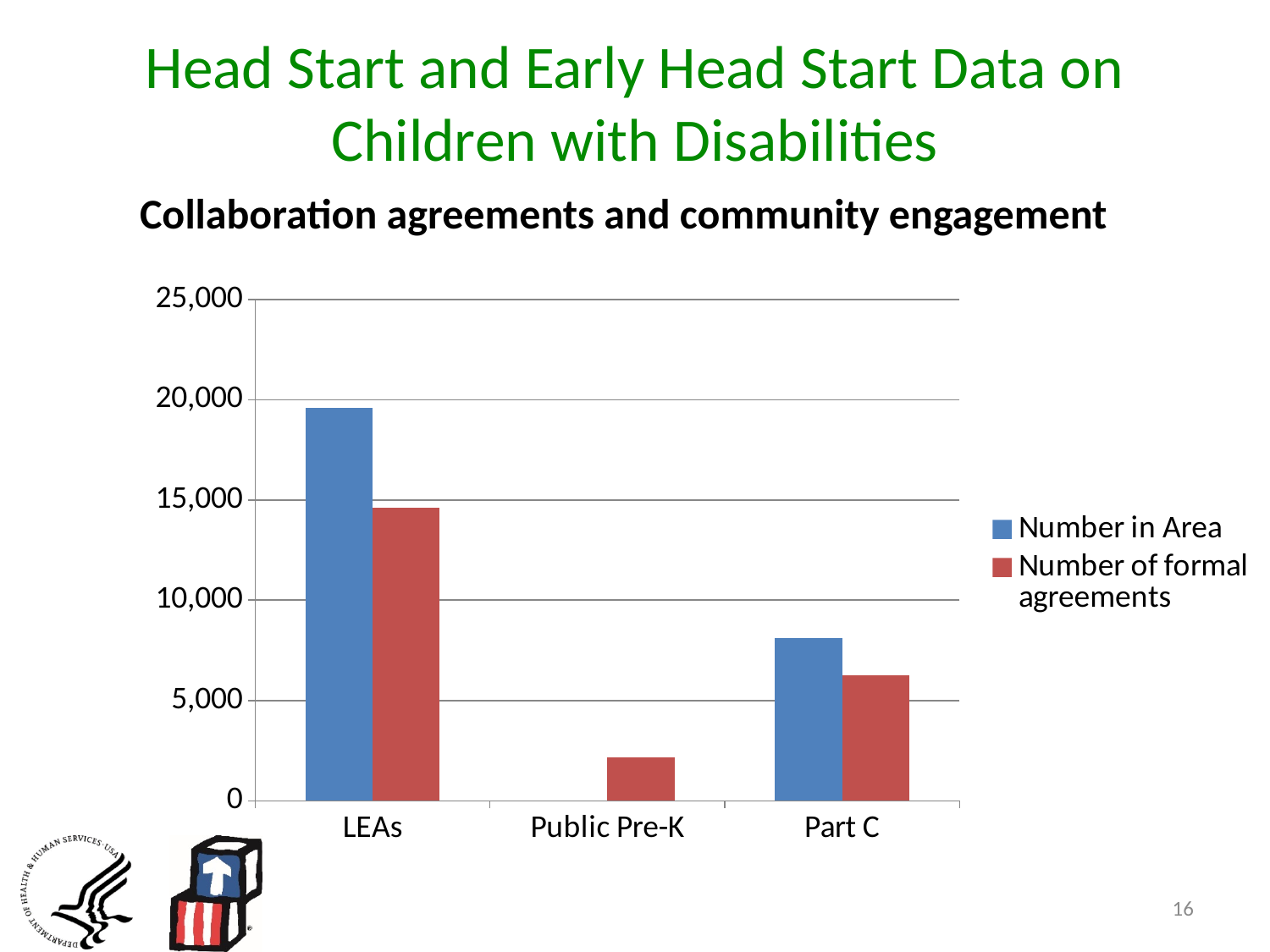
Is the Number of formal agreements value for Part C greater or less than 10,000? less How many categories are shown on the x axis of the chart? 3 What is the title of the chart? Collaboration agreements and community engagement Which category has the highest value for Number in Area? LEAs Is the Number in Area value for LEAs greater or less than 15,000? greater How many series does the chart's legend list? 2 For Part C, which is larger: Number in Area or Number of formal agreements? Number in Area Which is larger: the Number in Area for LEAs or the Number in Area for Part C? LEAs Is the Number of formal agreements value for Public Pre-K greater or less than 5,000? less What kind of chart is shown on the slide? bar chart Which category has the highest value for Number of formal agreements? LEAs Which category has the lowest value for Number of formal agreements? Public Pre-K